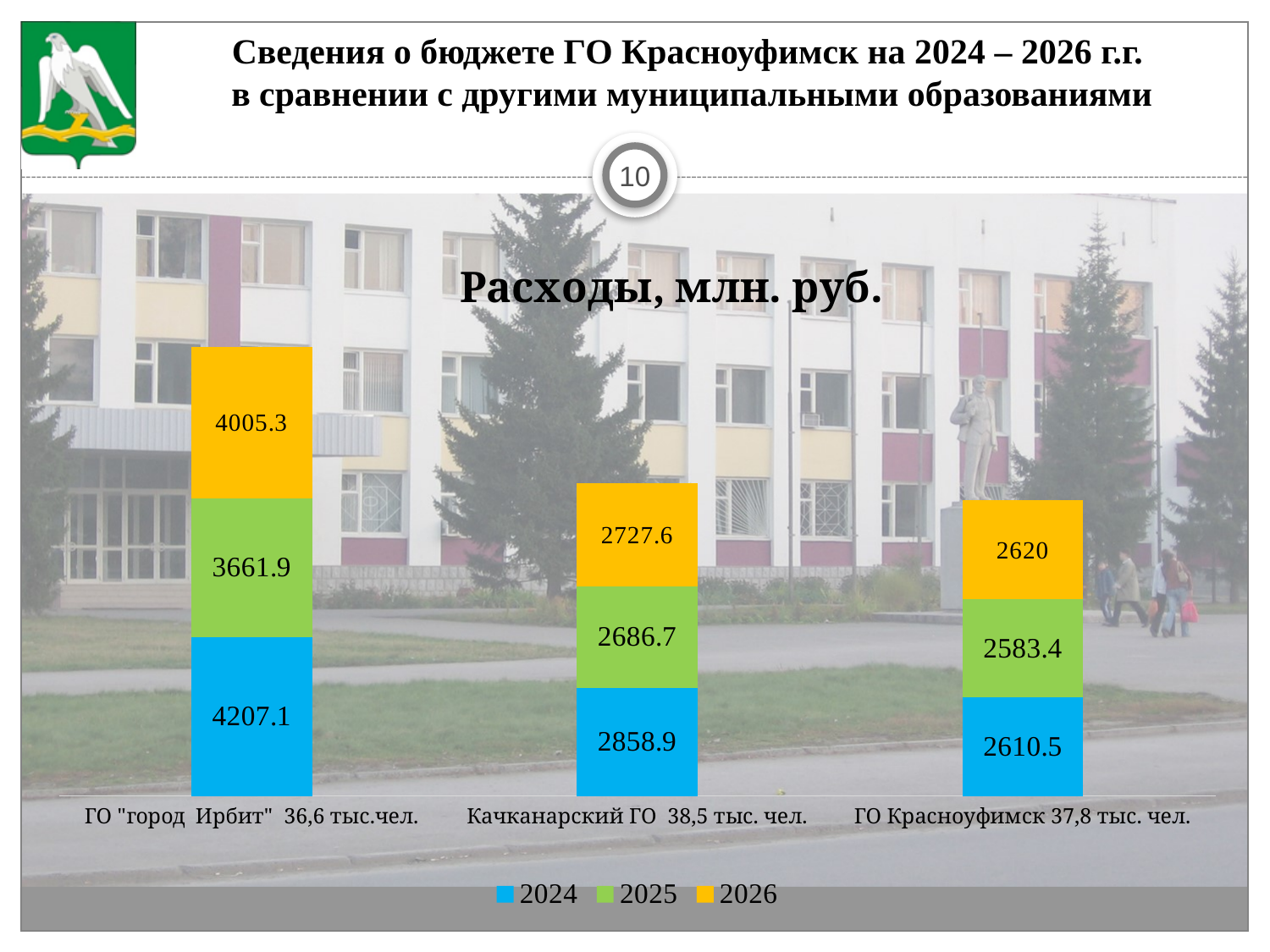
Which municipality has the lowest 2026 expenditure? ГО Красноуфимск What is the difference between the 2024 values for ГО "город Ирбит" and ГО Красноуфимск? 1596.6 What is the total of the stacked bar for ГО Красноуфимск? 7813.9 How many series does the legend list? 3 What is the 2024 value for ГО Красноуфимск in the Расходы, млн. руб. chart? 2610.5 What is the difference between the 2026 and 2025 values for Качканарский ГО? 40.9 What is the 2025 value for Качканарский ГО? 2686.7 Which is larger: the 2025 value for Качканарский ГО or the 2025 value for ГО Красноуфимск? Качканарский ГО What type of chart is shown on the slide? Stacked bar chart How many municipalities are shown on the x axis? 3 Which municipality has the highest 2024 expenditure? ГО "город Ирбит" What is the 2026 value for ГО "город Ирбит"? 4005.3